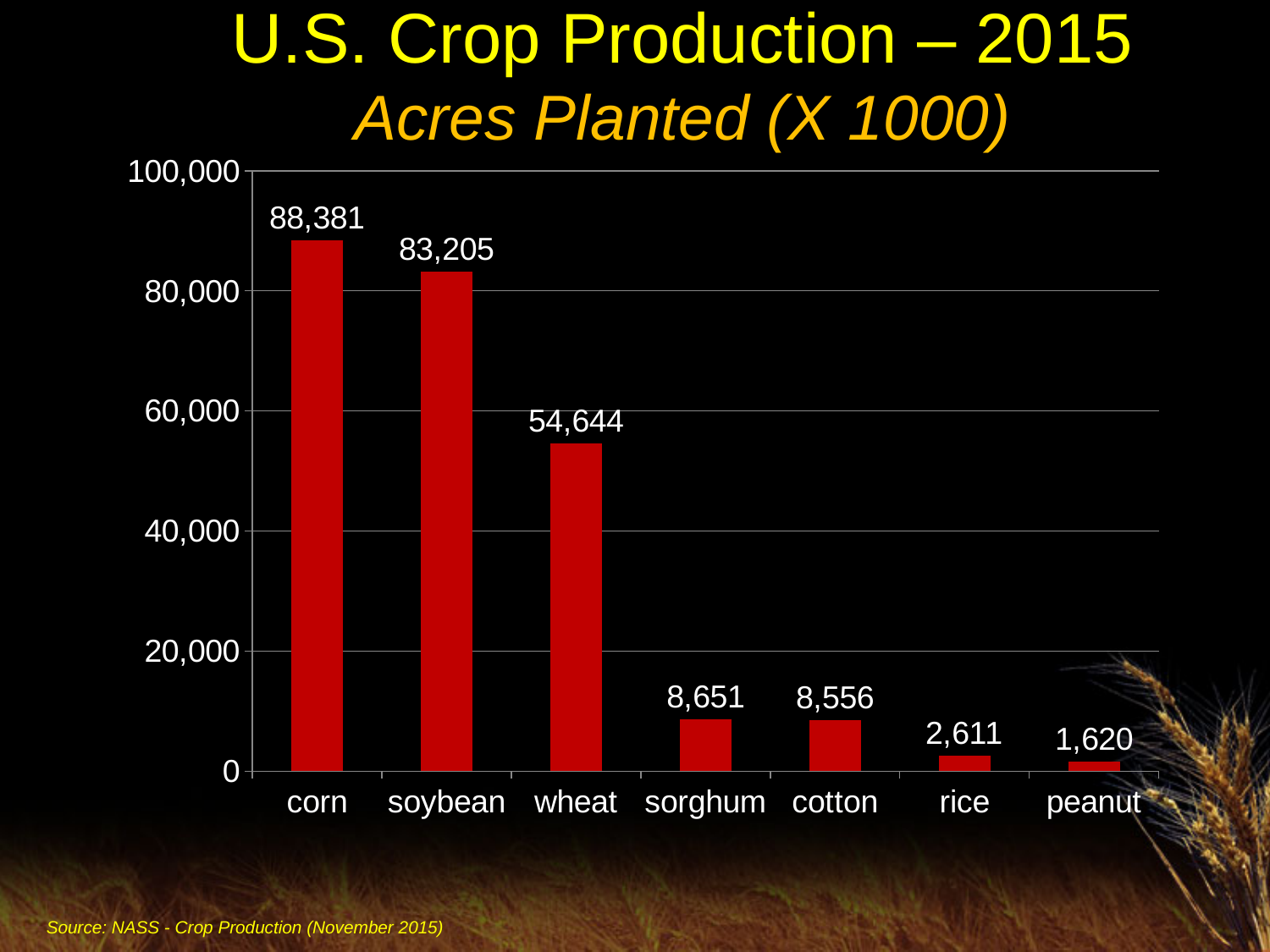
What is the subtitle of the chart? Acres Planted (X 1000) How many crops are shown on the chart? 7 Which crop has the highest acres planted? corn What is the value for corn? 88,381 What is the difference between the values for corn and soybean? 5,176 What is the value for rice? 2,611 Which crop has the lowest acres planted? peanut Which is larger, the value for soybean or the value for wheat? soybean What kind of chart is shown on the slide? bar chart What is the difference between the values for sorghum and cotton? 95 Is the value for wheat greater or less than 60,000? less What is the value for wheat? 54,644